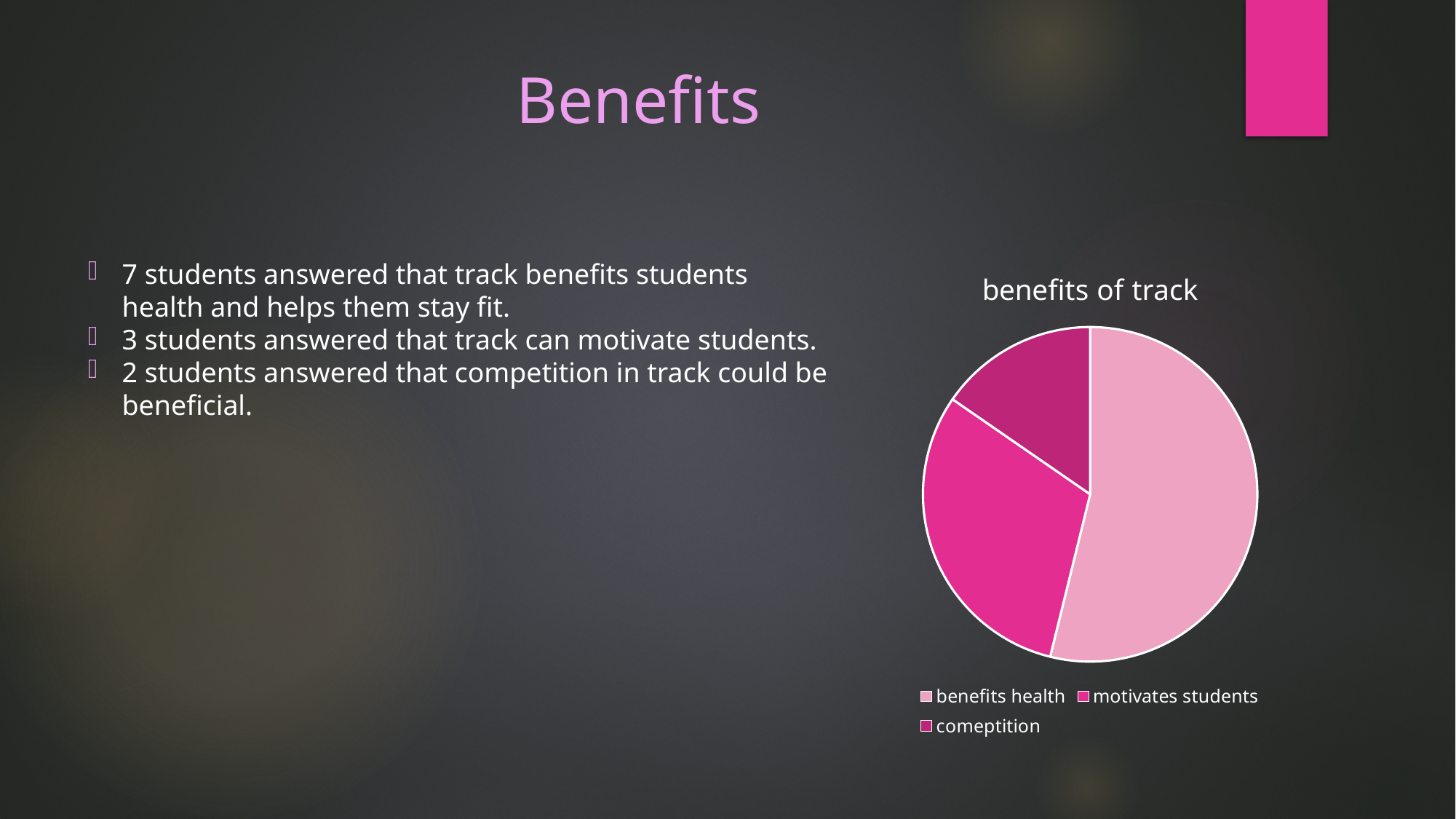
What kind of chart is shown on the slide? pie chart Which slice is larger: benefits health or motivates students? benefits health How many slices does the pie chart have? 3 How many entries does the chart legend list? 3 Which slice is larger: motivates students or comeptition? motivates students Which category has the largest slice of the pie? benefits health Which legend entry is shown in the lightest pink colour? benefits health What is the title of the chart? benefits of track Which category has the smallest slice of the pie? comeptition